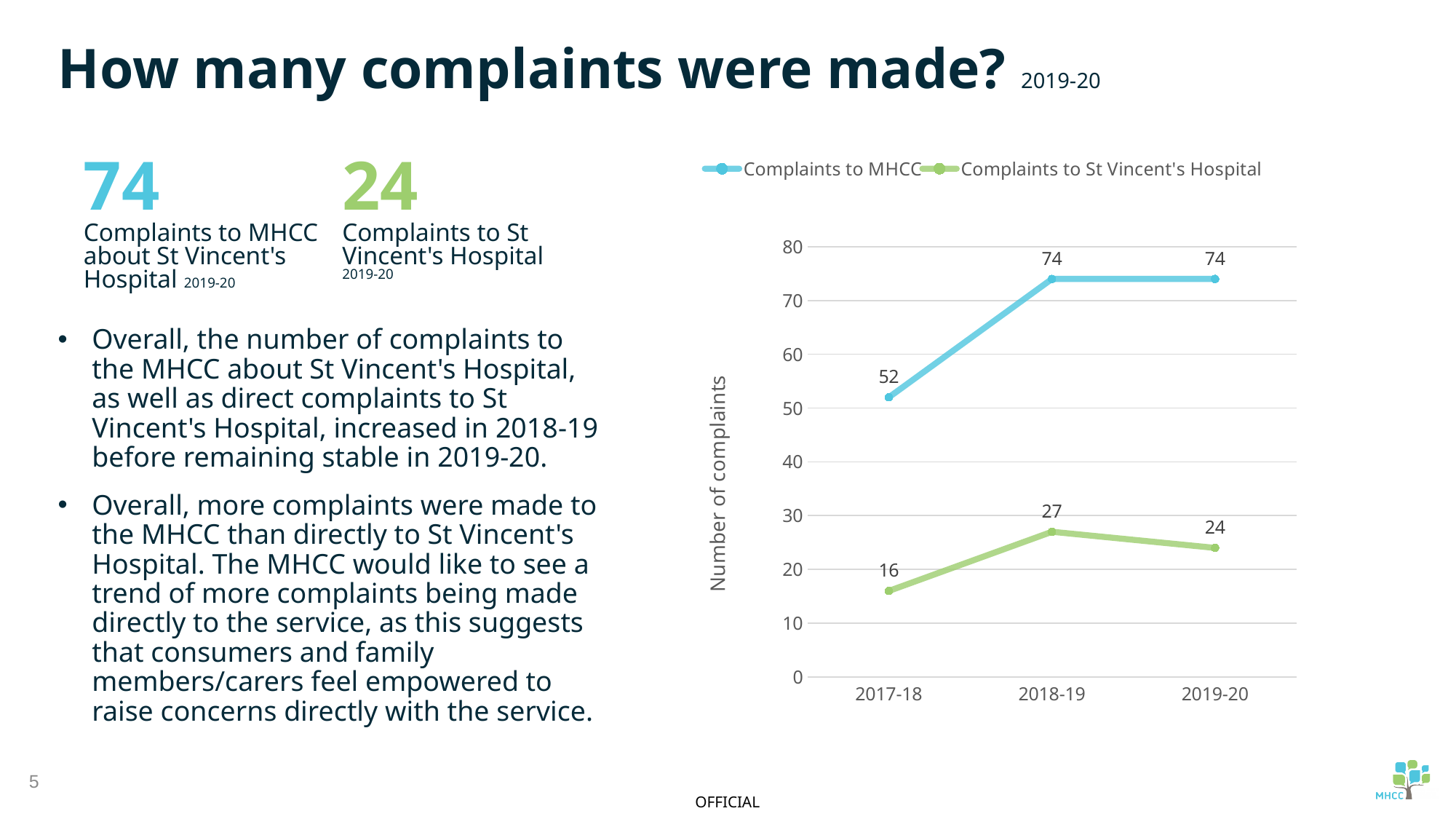
What is the label of the y axis? Number of complaints In which year was the value for Complaints to St Vincent's Hospital lowest? 2017-18 What is the value for Complaints to MHCC in 2017-18? 52 Does the value for Complaints to St Vincent's Hospital rise or fall from 2018-19 to 2019-20? fall How many years are plotted on the x axis? 3 What is the difference between Complaints to MHCC in 2018-19 and 2017-18? 22 What is the value for Complaints to St Vincent's Hospital in 2018-19? 27 What is the difference between Complaints to MHCC and Complaints to St Vincent's Hospital in 2019-20? 50 Which is larger in 2017-18, Complaints to MHCC or Complaints to St Vincent's Hospital? Complaints to MHCC What is the value for Complaints to MHCC in 2019-20? 74 What kind of chart is shown on the slide? line chart How many series does the legend list? 2